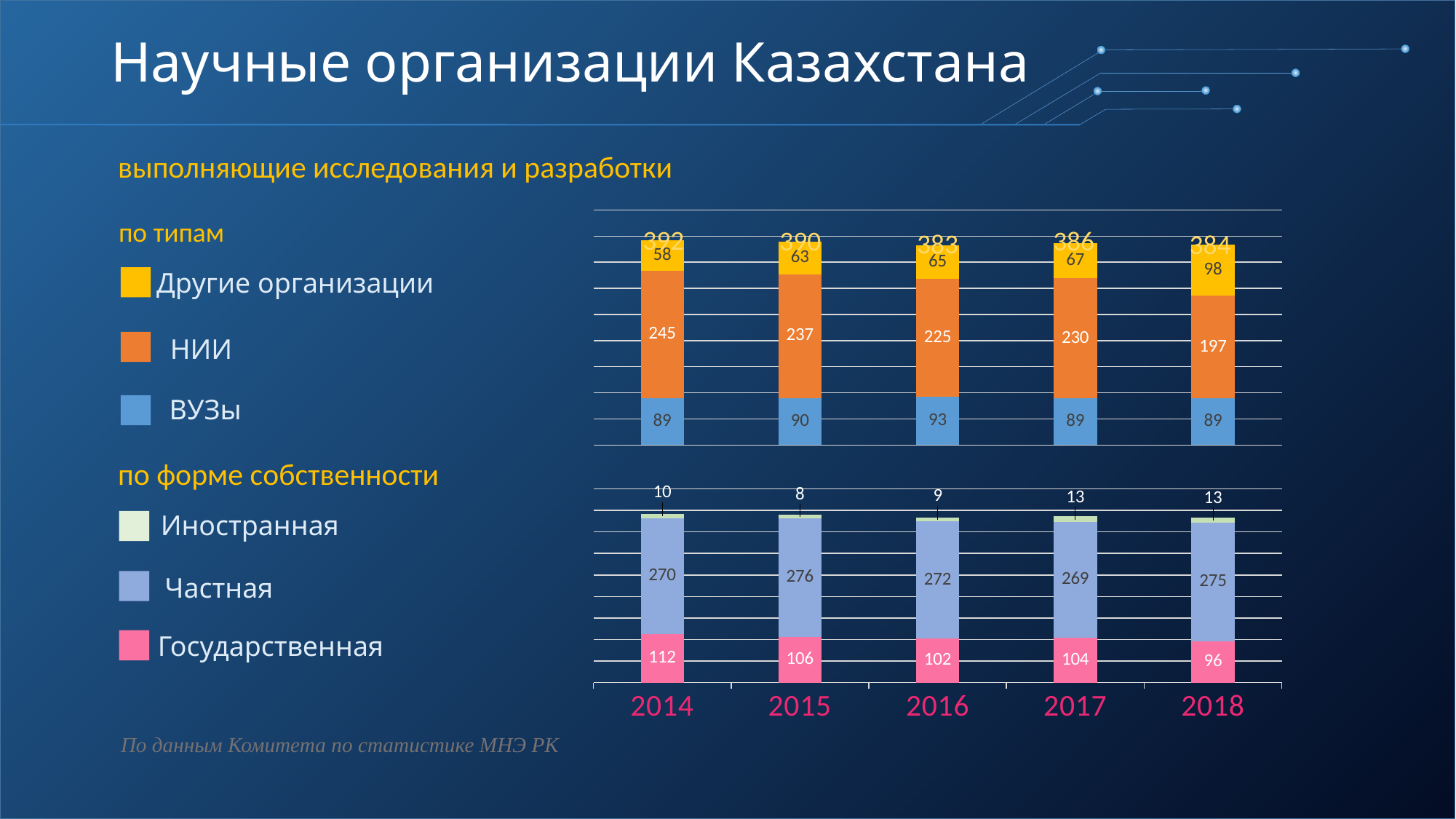
In the top chart (по типам), what is the value for Другие организации in 2018? 98 In the bottom chart (по форме собственности), what is the value for Государственная in 2016? 102 What kind of chart is the top chart (по типам)? Stacked bar chart In the top chart (по типам), what is the total of the stacked bar for 2016? 383 In the top chart (по типам), what is the value for НИИ in 2014? 245 In the bottom chart (по форме собственности), which year has the lowest value for Государственная? 2018 In the bottom chart (по форме собственности), what is the total of the stacked bar for 2014? 392 In the top chart (по типам), what is the difference between the НИИ values for 2014 and 2018? 48 In the bottom chart (по форме собственности), which is larger: Частная in 2015 or Частная in 2017? Частная in 2015 In the top chart (по типам), which year has the highest value for НИИ? 2014 In the bottom chart (по форме собственности), what is the value for Иностранная in 2017? 13 How many years are shown on the x axis of the charts? 5